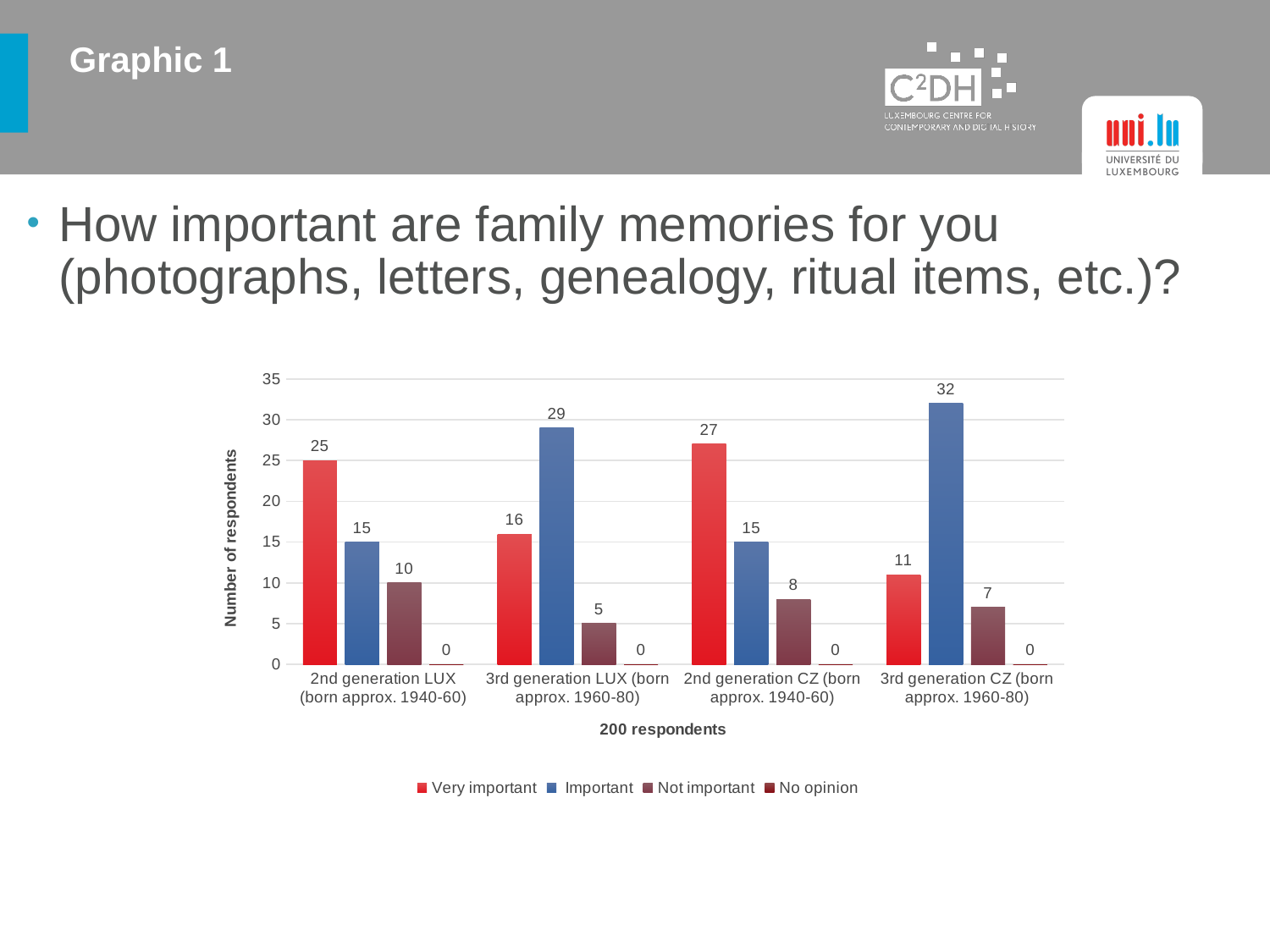
How many respondents in the 2nd generation LUX (born approx. 1940-60) group answered "Very important"? 25 What is the label of the vertical axis? Number of respondents What is the difference between "Very important" and "Important" in the 2nd generation CZ (born approx. 1940-60) group? 12 Which group has the lowest value for "Very important"? 3rd generation CZ (born approx. 1960-80) What is the value for "Important" in the 3rd generation CZ (born approx. 1960-80) group? 32 How many series does the legend list? 4 How many respondents in the 3rd generation LUX (born approx. 1960-80) group answered "Not important"? 5 Which is larger in the 2nd generation LUX (born approx. 1940-60) group: "Very important" or "Important"? Very important How many generation groups are shown on the x axis? 4 Which group has the highest value for "Important"? 3rd generation CZ (born approx. 1960-80) What is the value for "No opinion" in every group? 0 What kind of chart is shown on the slide? Bar chart